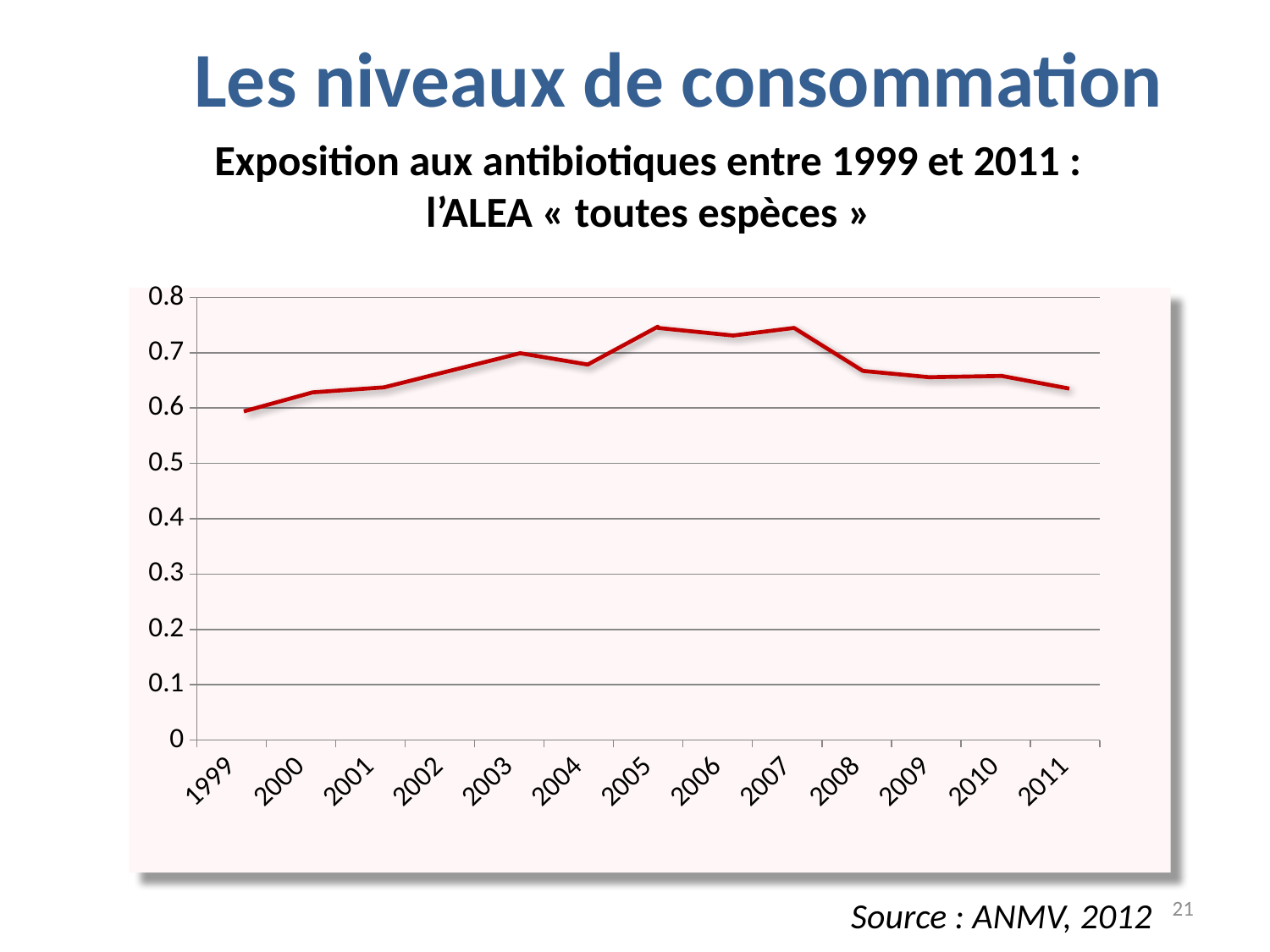
What colour is the line plotted on the chart? red Do the values rise or fall between 1999 and 2003? rise Which is larger, the value for 2005 or the value for 2011? 2005 Is the value for 2004 greater or less than 0.7? less How many years are plotted on the x axis of the chart? 13 Which year has the lowest value on the chart? 1999 Is the value for 2008 greater or less than 0.7? less What kind of chart is shown on the slide? line chart Is the value for 2011 greater or less than 0.6? greater Do the values rise or fall between 2007 and 2011? fall Which is larger, the value for 1999 or the value for 2003? 2003